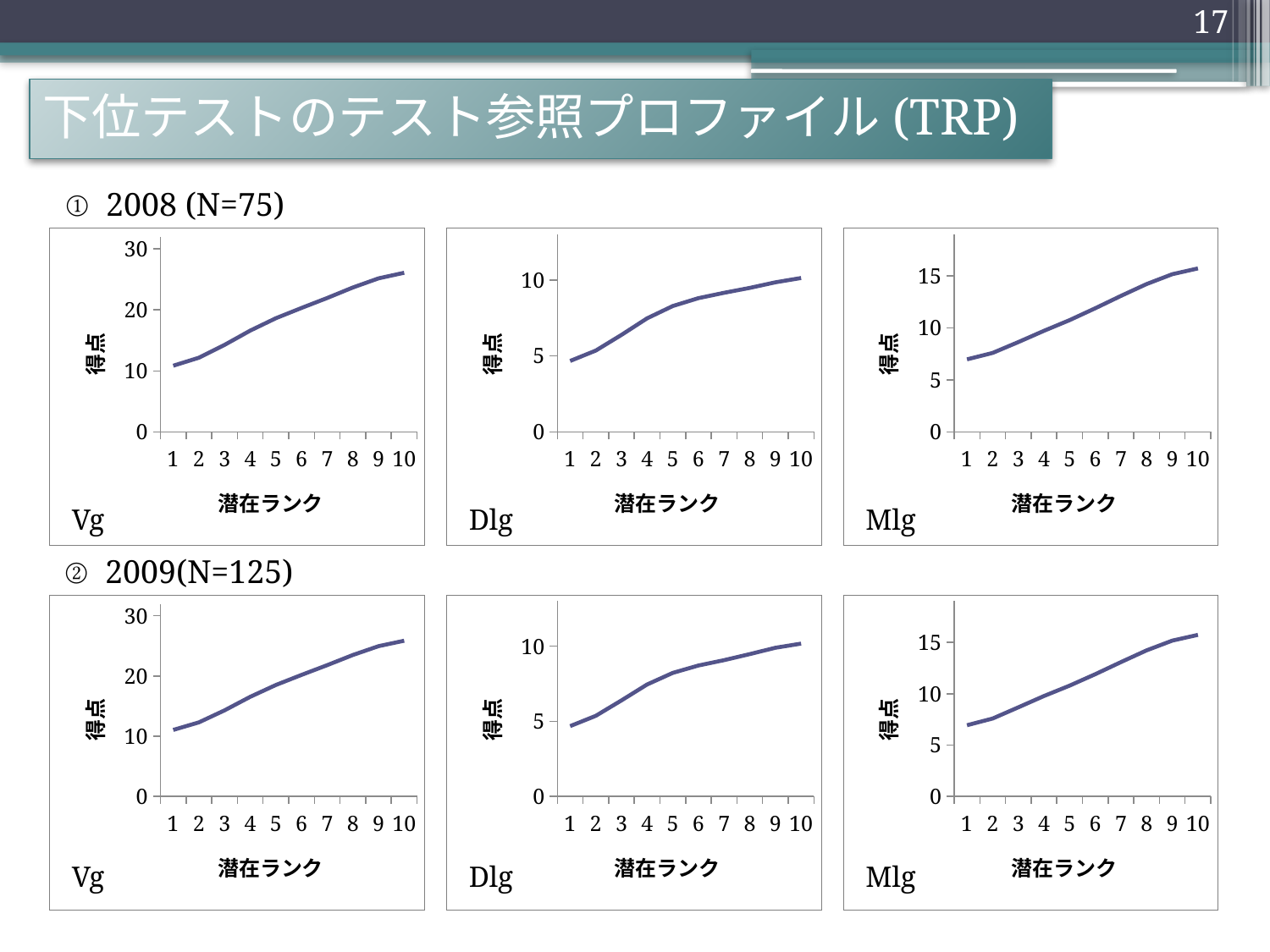
How many 潜在ランク points are plotted on the x axis of the 2008 Mlg chart (top right)? 10 In the 2009 Vg chart (bottom left), is the value at 潜在ランク 10 greater or less than 20? greater In the 2008 Vg chart (top left), is the value at 潜在ランク 1 greater or less than 20? less In the 2008 Vg chart (top left), do the values rise or fall as 潜在ランク increases from 1 to 10? rise In the 2008 Vg chart (top left), is the value at 潜在ランク 10 greater or less than 20? greater What type of chart is the 2008 Vg chart (top left)? line chart In the 2009 Dlg chart (bottom middle), do the values rise or fall along the x axis? rise What is the y-axis title of the 2008 Dlg chart (top middle)? 得点